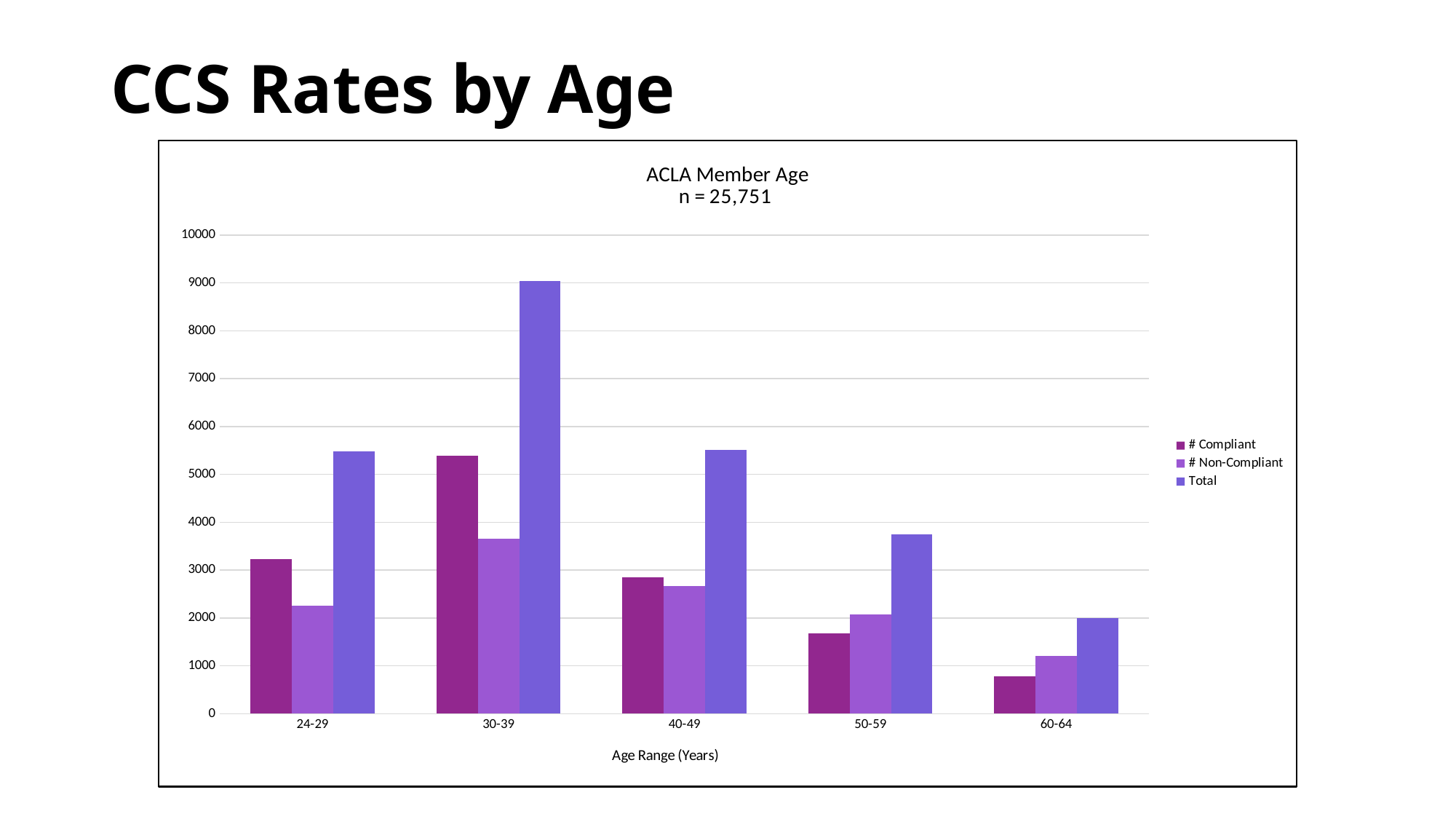
Which age range has the lowest # Compliant value? 60-64 How many series does the legend list? 3 What kind of chart is shown on the slide? Bar chart Which age range has the highest Total? 30-39 What is the x-axis title of the chart? Age Range (Years) How many age ranges are shown on the x axis? 5 Does the Total rise or fall from 30-39 through 60-64? Fall Is the Total for 30-39 greater or less than 8000? greater Is the # Compliant value for 24-29 greater or less than 3000? greater Is the # Non-Compliant value for 60-64 greater or less than 1000? greater For the 50-59 age range, which is larger: # Compliant or # Non-Compliant? # Non-Compliant Which age range has the highest # Non-Compliant value? 30-39